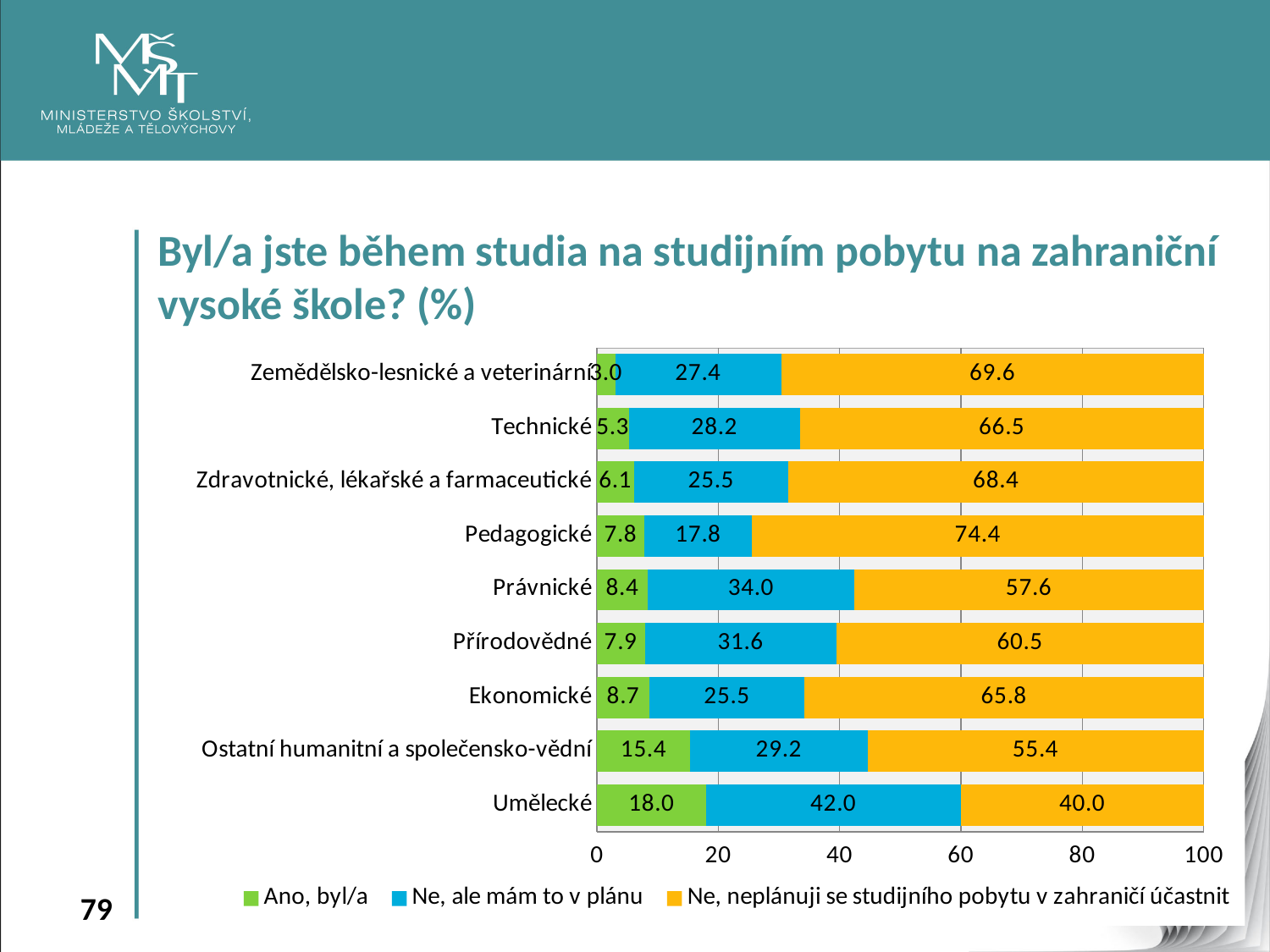
What is the difference between the "Ne, ale mám to v plánu" values for Umělecké and Pedagogické? 24.2 Which category has the lowest value for "Ne, neplánuji se studijního pobytu v zahraničí účastnit"? Umělecké How many series does the legend list? 3 What is the value of "Ne, ale mám to v plánu" for Právnické? 34.0 Which category has the highest value for "Ne, neplánuji se studijního pobytu v zahraničí účastnit"? Pedagogické What is the value of "Ano, byl/a" for Umělecké? 18.0 What is the value of "Ne, neplánuji se studijního pobytu v zahraničí účastnit" for Pedagogické? 74.4 What kind of chart is shown on the slide? Stacked bar chart How many categories are shown on the chart? 9 Which has the larger "Ano, byl/a" value, Ekonomické or Přírodovědné? Ekonomické What colour represents "Ano, byl/a" in the legend? Green Which category has the highest value for "Ano, byl/a"? Umělecké